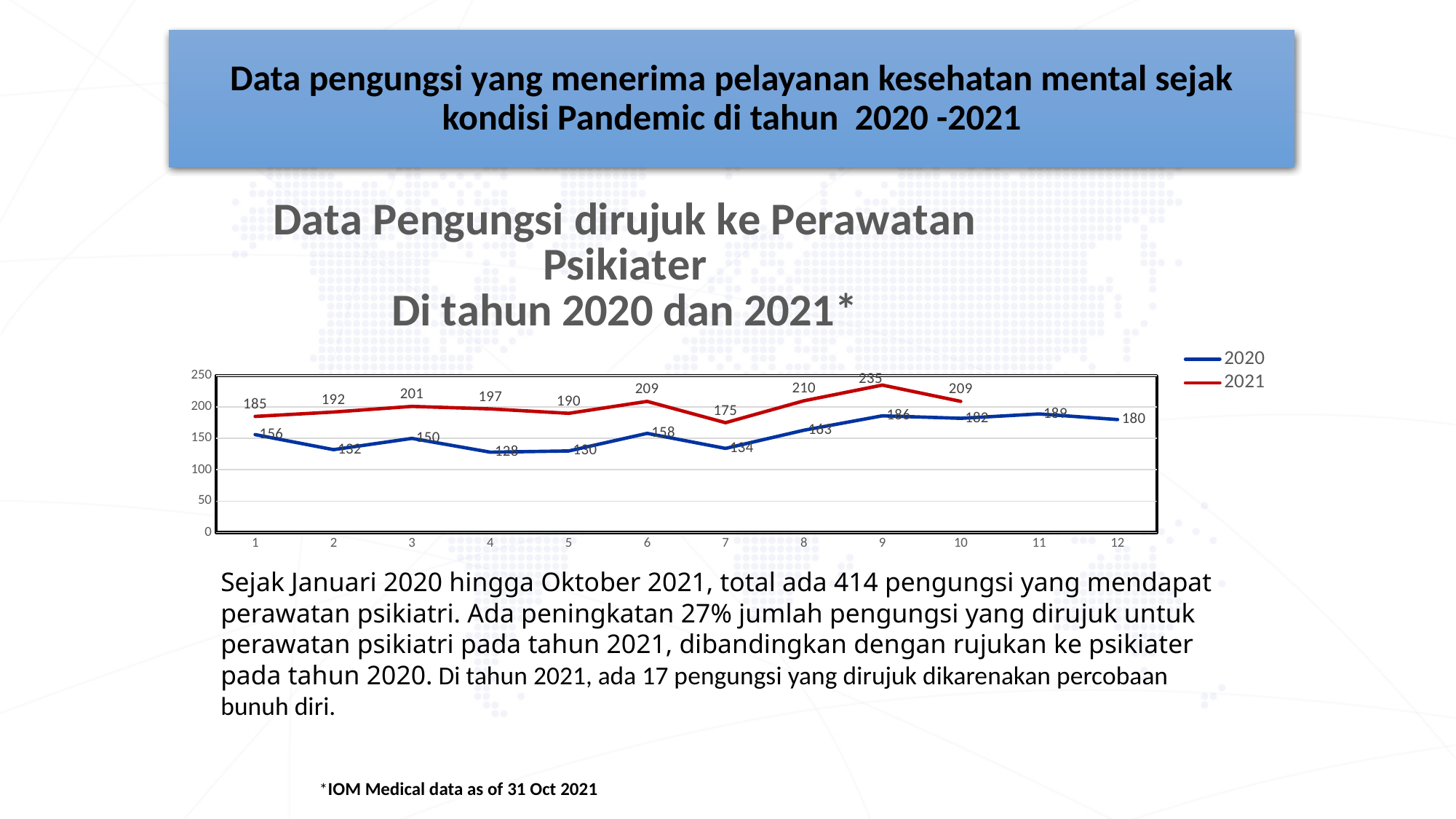
At which x-axis point does the 2020 series reach its lowest value? 4 What is the difference between the 2021 value and the 2020 value at point 1? 29 What colour is the line for the 2021 series? red How many series does the legend list? 2 At point 6, which series has the larger value, 2020 or 2021? 2021 At which x-axis point does the 2021 series reach its highest value? 9 How many data points are plotted for the 2021 series? 10 What is the value for the 2021 series at point 7? 175 What is the value for the 2021 series at point 9? 235 What kind of chart is shown on the slide? line chart Is the value for the 2020 series at point 2 greater or less than 150? less What is the value for the 2020 series at point 1? 156